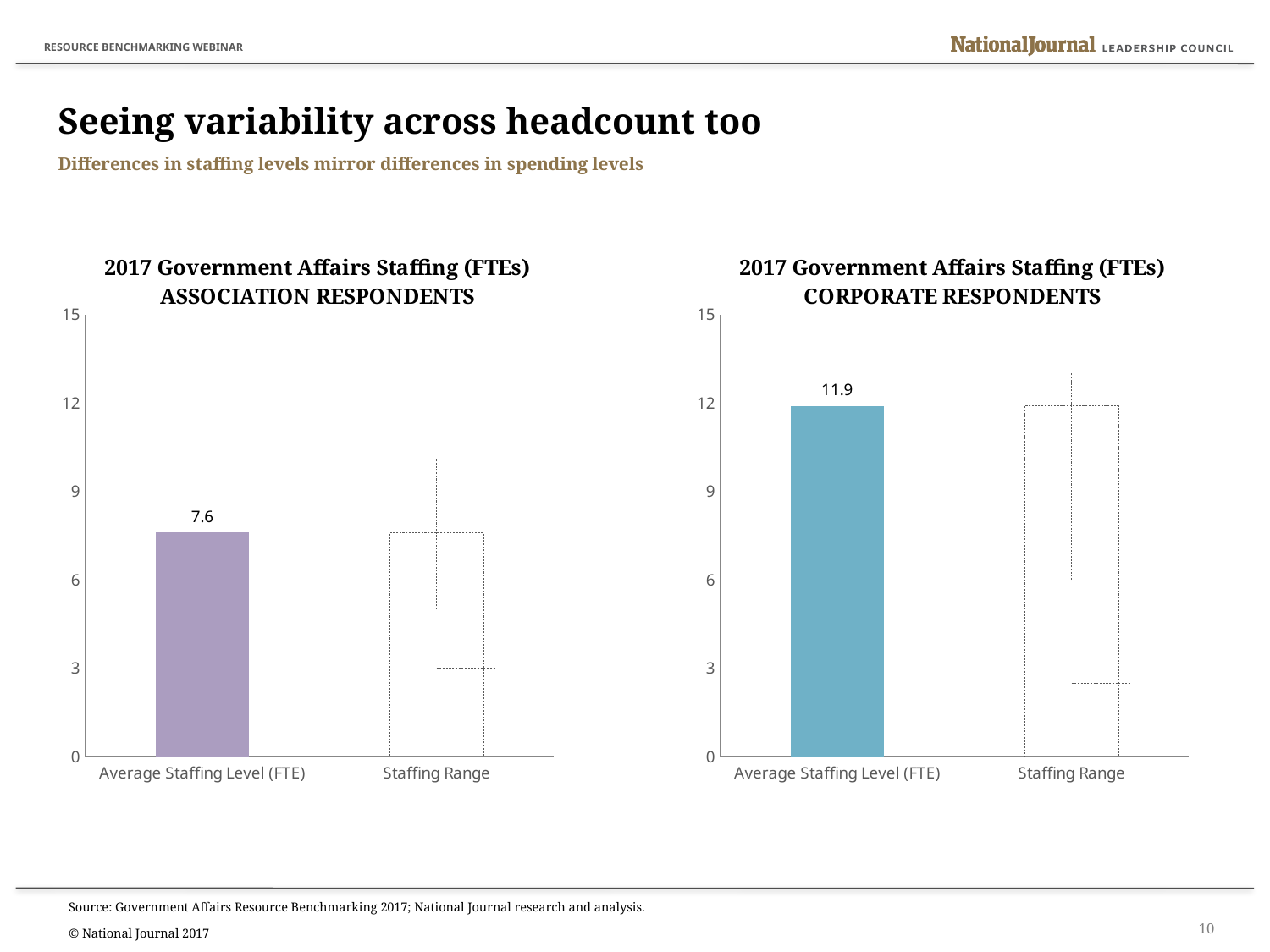
In the CORPORATE RESPONDENTS chart, is the Average Staffing Level (FTE) greater or less than 9? greater Comparing the two charts, which group has the higher Average Staffing Level (FTE): association respondents or corporate respondents? Corporate respondents What kind of chart is the 2017 Government Affairs Staffing (FTEs) ASSOCIATION RESPONDENTS chart? Bar chart How many categories are shown on the x axis of the CORPORATE RESPONDENTS chart? 2 What is the difference between the corporate respondents' Average Staffing Level (11.9) and the association respondents' Average Staffing Level (7.6)? 4.3 What is the title of the chart on the right side of the slide? 2017 Government Affairs Staffing (FTEs) CORPORATE RESPONDENTS In the 2017 Government Affairs Staffing (FTEs) CORPORATE RESPONDENTS chart, what is the Average Staffing Level (FTE)? 11.9 What is the maximum value shown on the y axis of the ASSOCIATION RESPONDENTS chart? 15 In the 2017 Government Affairs Staffing (FTEs) ASSOCIATION RESPONDENTS chart, what is the Average Staffing Level (FTE)? 7.6 In the ASSOCIATION RESPONDENTS chart, is the Average Staffing Level (FTE) greater or less than 6? greater In the ASSOCIATION RESPONDENTS chart, is the Average Staffing Level (FTE) greater or less than 9? less